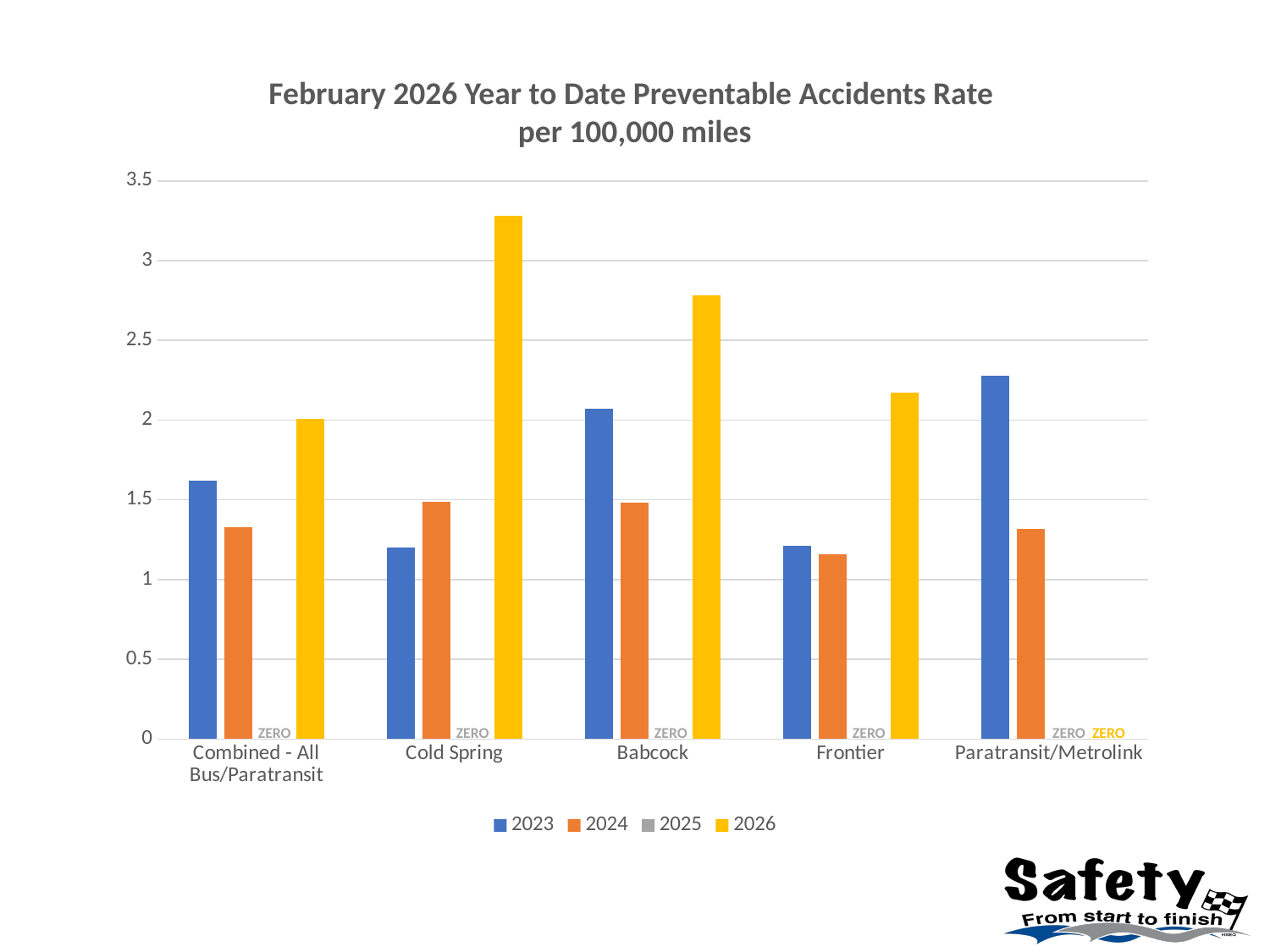
Which category has the highest 2026 value? Cold Spring What is the 2026 value for Paratransit/Metrolink? ZERO What is the title of the chart? February 2026 Year to Date Preventable Accidents Rate per 100,000 miles For Babcock, which is larger: the 2023 value or the 2024 value? 2023 Is the 2023 value for Paratransit/Metrolink greater or less than 2? greater How many series does the legend list? 4 Which category has the highest 2023 value? Paratransit/Metrolink What is the 2025 value for Babcock? ZERO How many categories are shown on the x axis? 5 Is the 2026 value for Cold Spring greater or less than 3? greater What kind of chart is shown on the slide? Bar chart Is the 2024 value for Frontier greater or less than 1.5? less